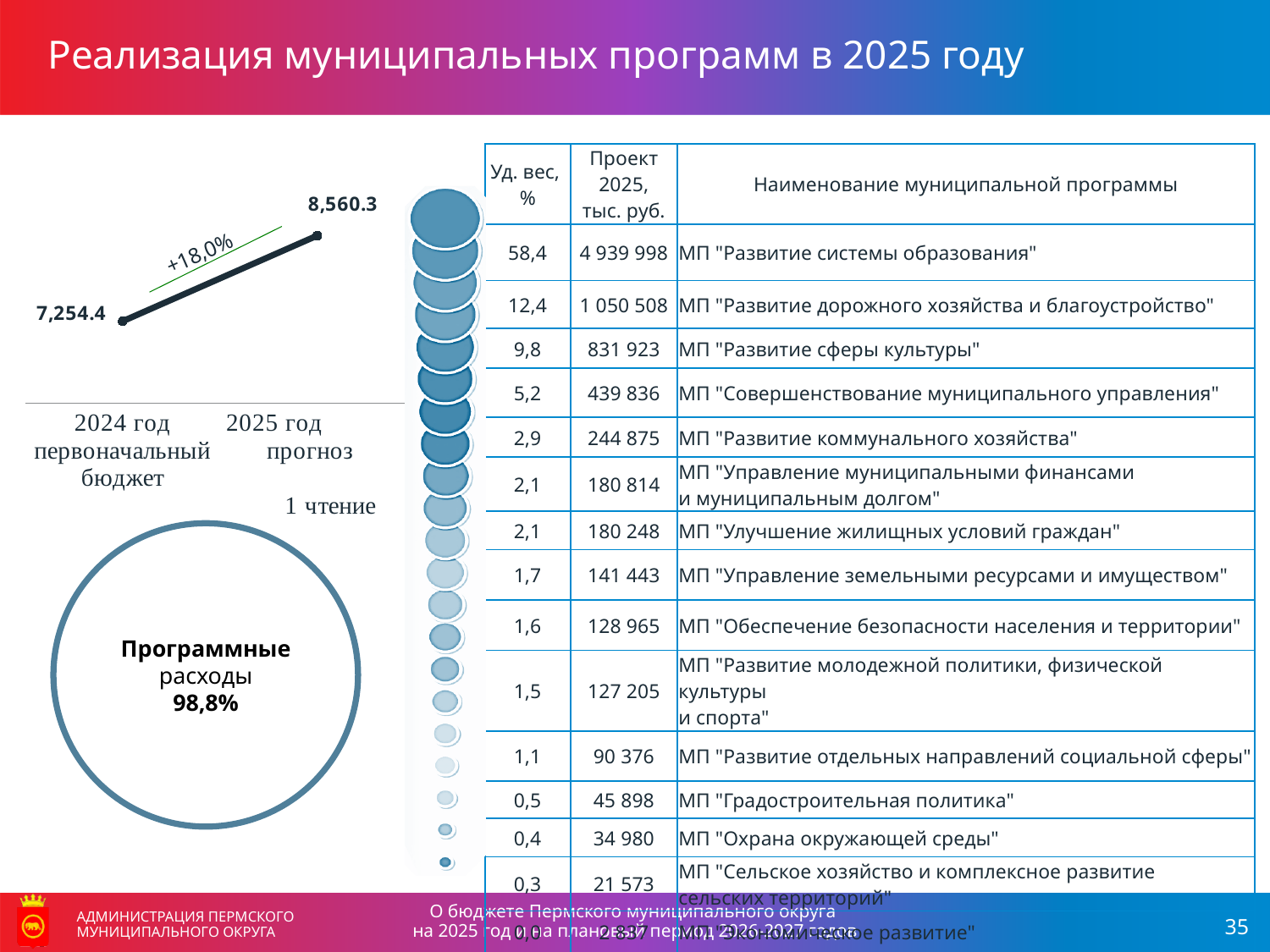
On the line chart, what is the value for 2025 год прогноз 1 чтение? 8,560.3 How many data points are plotted on the line chart? 2 On the line chart, which of the two points is higher: 2024 год первоначальный бюджет or 2025 год прогноз 1 чтение? 2025 год прогноз 1 чтение What kind of chart is the chart in the upper left of the slide showing 7,254.4 and 8,560.3? line chart On the line chart, do the values rise or fall from 2024 to 2025? rise Is the value for 2025 год прогноз 1 чтение on the line chart greater or less than 8,000? greater On the line chart, which category has the lowest value? 2024 год первоначальный бюджет On the line chart, what is the value for 2024 год первоначальный бюджет? 7,254.4 What percentage change is labelled on the line chart between the 2024 and 2025 points? +18,0% On the circle graphic in the lower left, what share is shown for Программные расходы? 98,8% On the line chart, what is the difference between the 2025 год прогноз 1 чтение value and the 2024 год первоначальный бюджет value? 1,305.9 On the line chart, which category has the highest value? 2025 год прогноз 1 чтение